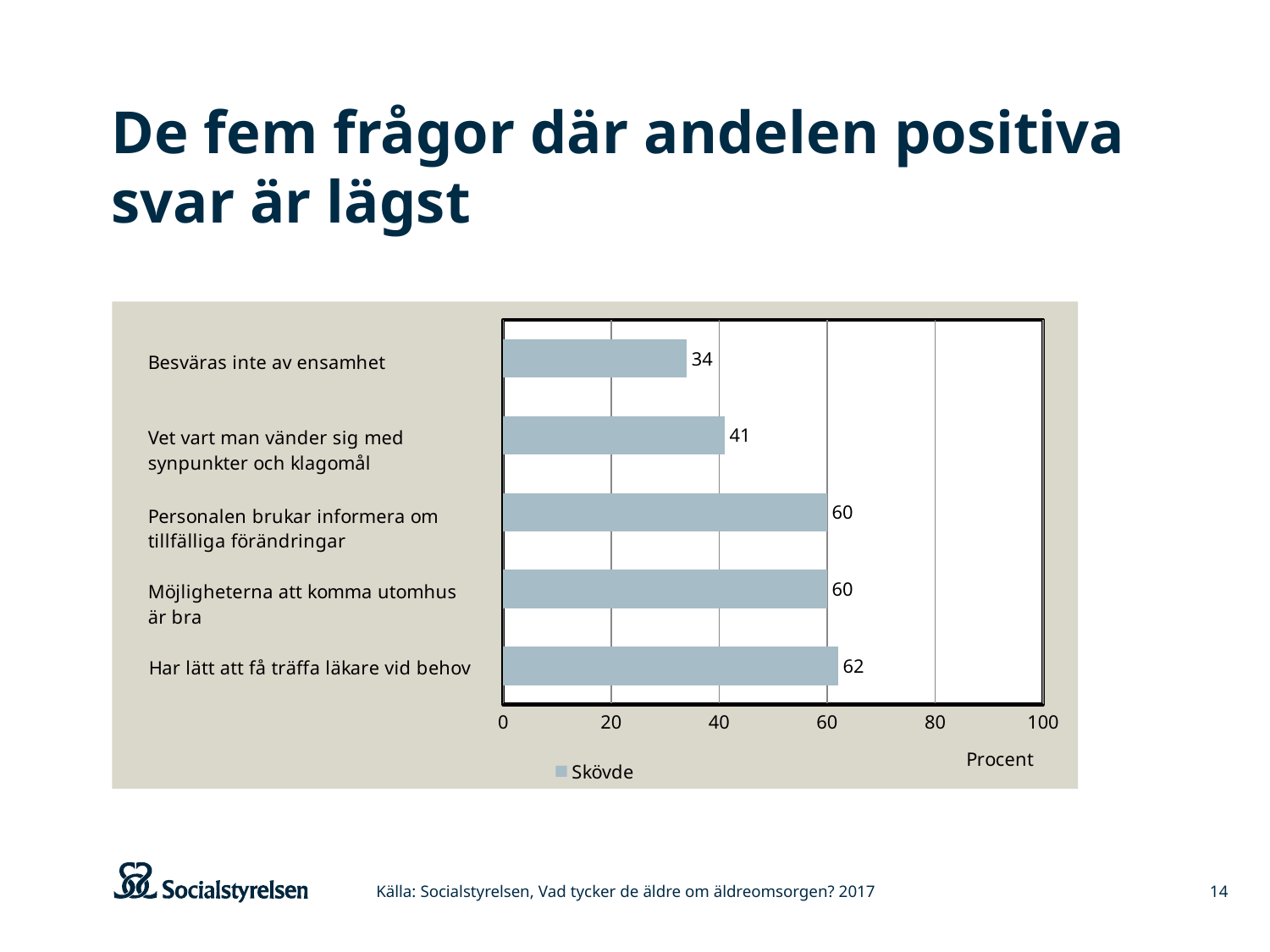
How many categories are shown in the chart? 5 What is the value for "Har lätt att få träffa läkare vid behov"? 62 How many series does the legend list? 1 Which category has the lowest value? Besväras inte av ensamhet Which category has the highest value? Har lätt att få träffa läkare vid behov What is the value for "Besväras inte av ensamhet"? 34 Is the value for "Besväras inte av ensamhet" greater or less than 40? less What is the value for "Möjligheterna att komma utomhus är bra"? 60 Which is larger: the value for "Vet vart man vänder sig med synpunkter och klagomål" or the value for "Personalen brukar informera om tillfälliga förändringar"? Personalen brukar informera om tillfälliga förändringar What kind of chart is shown on the slide? bar chart What is the difference between the values for "Har lätt att få träffa läkare vid behov" and "Besväras inte av ensamhet"? 28 What is the value for "Vet vart man vänder sig med synpunkter och klagomål"? 41